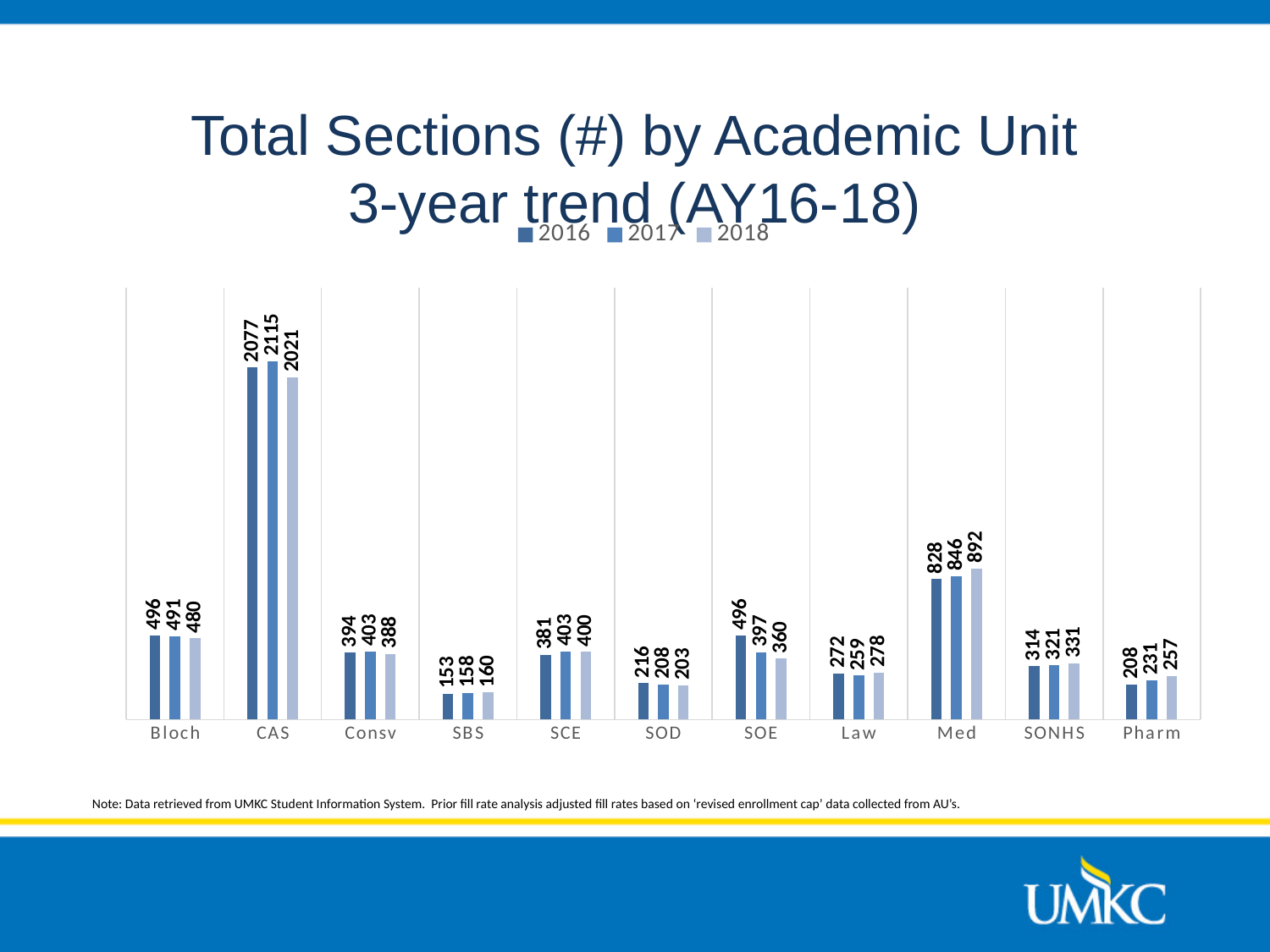
Which academic unit has the highest value in 2018? CAS Which is larger for Pharm: the 2016 value or the 2018 value? 2018 What is the title of the chart? Total Sections (#) by Academic Unit 3-year trend (AY16-18) Do the values for Med rise or fall from 2016 to 2018? Rise What is the value for CAS in 2017? 2115 How many academic units are shown on the x axis? 11 What is the value for Med in 2018? 892 What is the value for SBS in 2016? 153 Which academic unit has the lowest value in 2016? SBS What is the difference between the 2016 and 2018 values for SOE? 136 What kind of chart is shown on the slide? Bar chart How many series does the legend list? 3